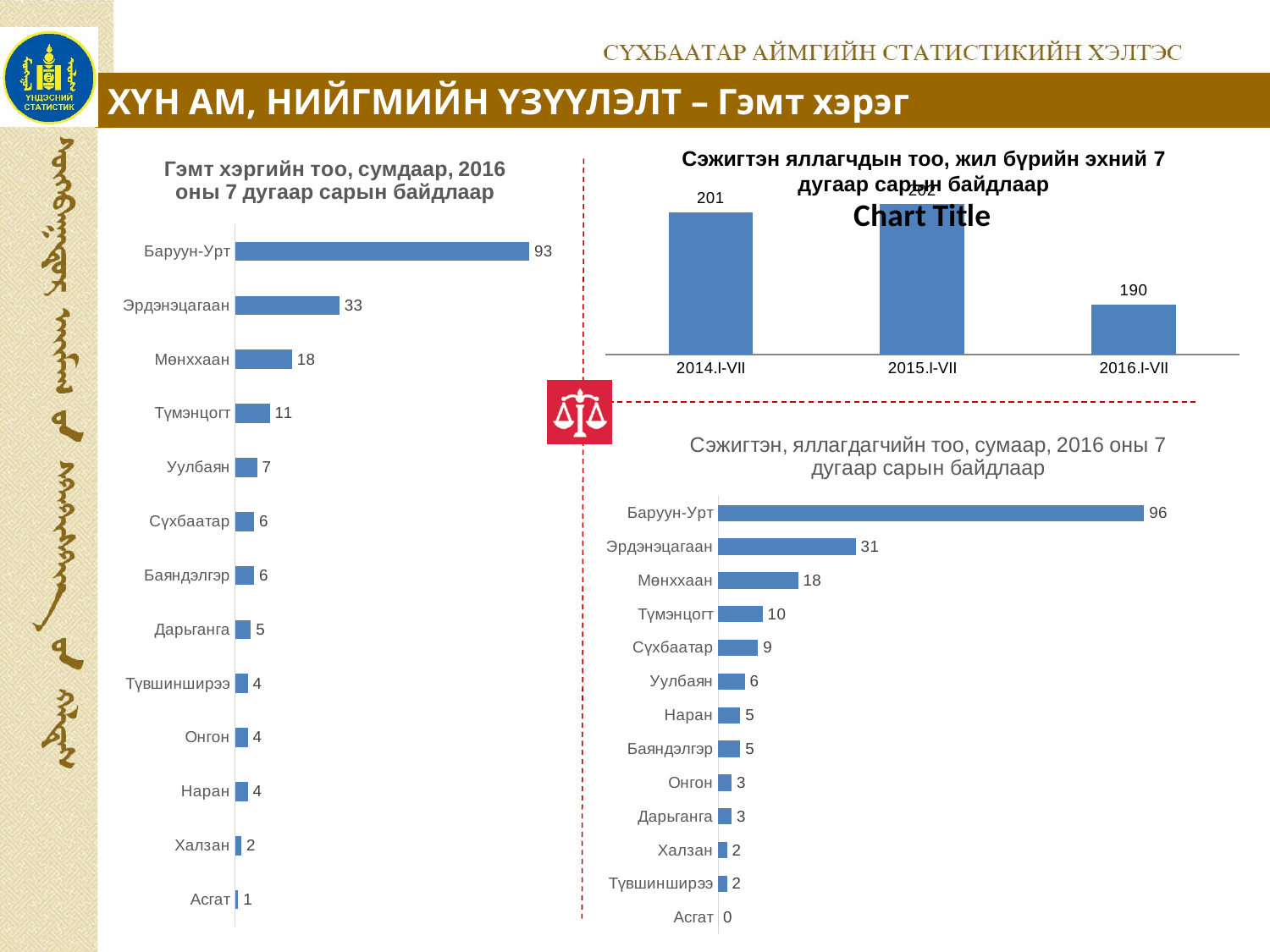
In the bottom-right chart 'Сэжигтэн, яллагдагчийн тоо, сумаар, 2016 оны 7 дугаар сарын байдлаар', what is the value for Баруун-Урт? 96 In the left chart 'Гэмт хэргийн тоо, сумдаар, 2016 оны 7 дугаар сарын байдлаар', what is the value for Баруун-Урт? 93 In the top-right chart 'Сэжигтэн яллагчдын тоо', what is the value for 2016.I-VII? 190 In the top-right chart 'Сэжигтэн яллагчдын тоо, жил бүрийн эхний 7 дугаар сарын байдлаар', what is the value for 2014.I-VII? 201 In the left chart 'Гэмт хэргийн тоо, сумдаар', what is the difference between Эрдэнэцагаан and Мөнххаан? 15 In the bottom-right chart 'Сэжигтэн, яллагдагчийн тоо, сумаар', what is the value for Асгат? 0 What type of chart is the top-right chart 'Сэжигтэн яллагчдын тоо'? Bar chart In the bottom-right chart 'Сэжигтэн, яллагдагчийн тоо, сумаар', what is the difference between Баруун-Урт and Эрдэнэцагаан? 65 In the left chart 'Гэмт хэргийн тоо, сумдаар', which category has the lowest value? Асгат In the left chart 'Гэмт хэргийн тоо, сумдаар', how many categories are shown? 13 In the top-right chart 'Сэжигтэн яллагчдын тоо', which is larger, 2014.I-VII or 2016.I-VII? 2014.I-VII In the left chart 'Гэмт хэргийн тоо, сумдаар', what is the value for Түмэнцогт? 11